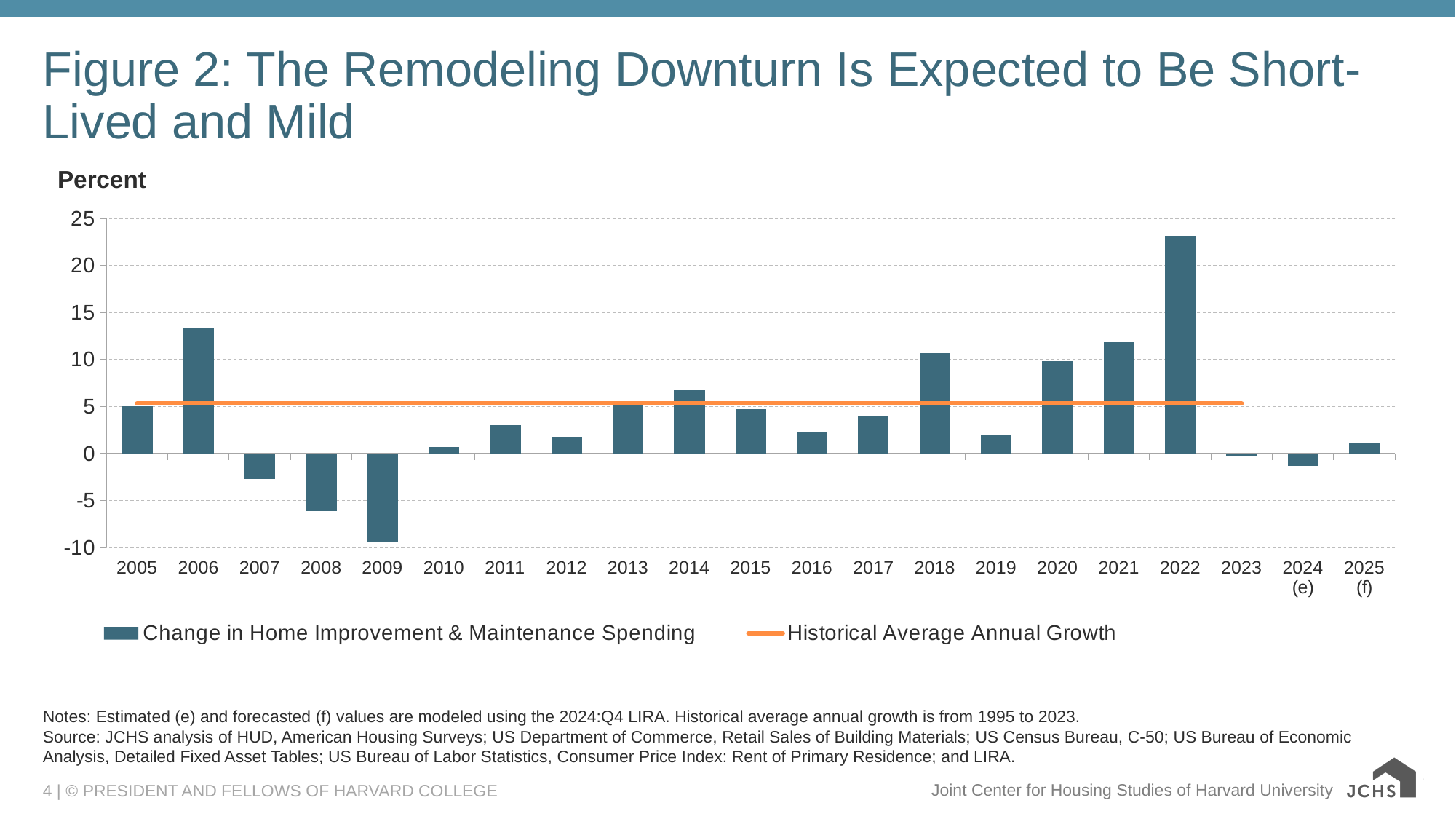
Do the values rise or fall from 2019 to 2022? Rise Is the value for 2009 greater or less than -5? less How many series does the legend list? 2 Which year has the larger change in spending, 2006 or 2021? 2006 Is the value for 2016 greater or less than 5? less How many years are shown along the x axis? 21 Is the value for 2022 greater or less than 20? greater Which year has the highest change in home improvement and maintenance spending? 2022 What does the orange line in the chart represent? Historical Average Annual Growth What kind of chart is shown on the slide? Combination bar and line chart Which year has the lowest change in home improvement and maintenance spending? 2009